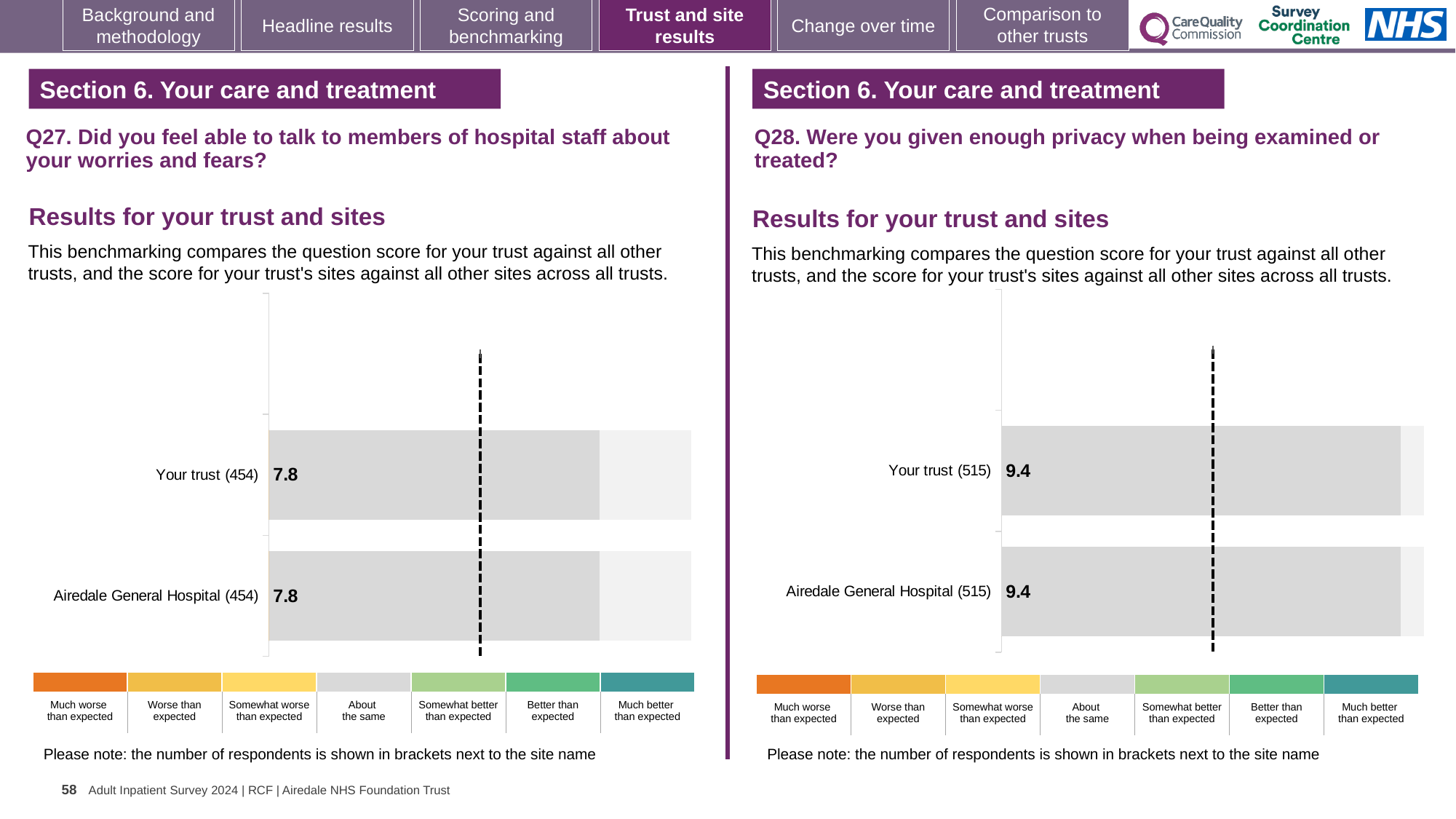
In the Q27 chart on the left, what is the difference between the score for Your trust and the score for Airedale General Hospital? 0 In the Q27 chart on the left, what is the score for Airedale General Hospital? 7.8 In the Q28 chart on the right, what is the difference between the score for Your trust and the score for Airedale General Hospital? 0 How many bars are plotted in the Q28 chart on the right? 2 In the Q27 chart on the left, how many respondents are shown in brackets next to Your trust? 454 In the Q28 chart on the right, what is the score for Your trust? 9.4 In the Q28 chart on the right, how many respondents are shown in brackets next to Airedale General Hospital? 515 In the Q27 chart on the left, what is the score for Your trust? 7.8 What kind of chart is used for the Q27 results on the left? Bar chart How many bars are plotted in the Q27 chart on the left? 2 In the Q28 chart on the right, what is the score for Airedale General Hospital? 9.4